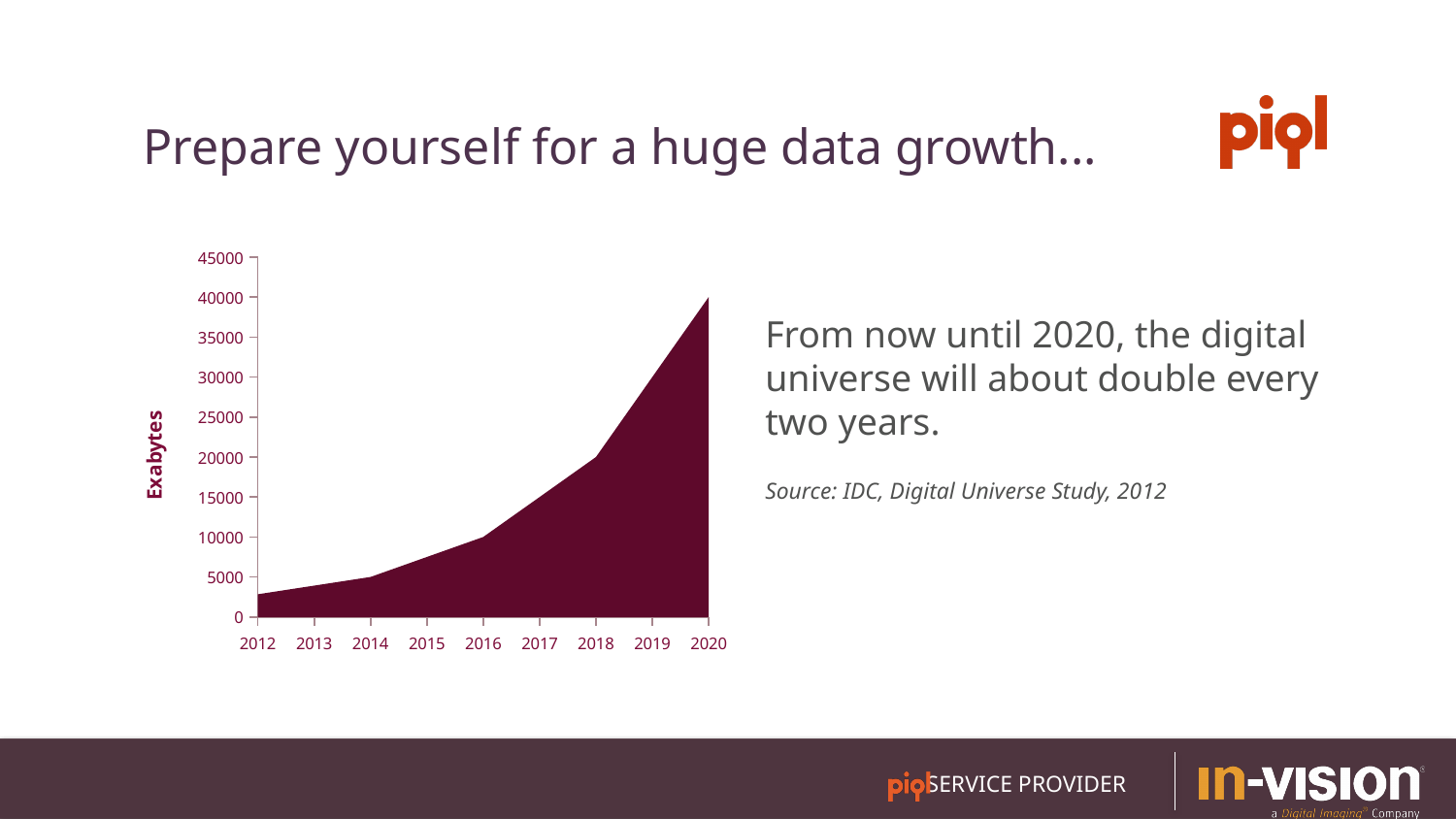
What is the first year shown on the x axis of the chart? 2012 What kind of chart is shown on the slide? area chart Do the values rise or fall from 2012 to 2020? rise What is the label on the y axis of the chart? Exabytes Is the value for 2020 greater or less than 35000? greater Which year has the highest value in the chart? 2020 How many years are plotted along the x axis of the chart? 9 Which year has the larger value, 2016 or 2018? 2018 Which year has the lowest value in the chart? 2012 Is the value for 2012 greater or less than 5000? less Is the value for 2019 greater or less than 25000? greater